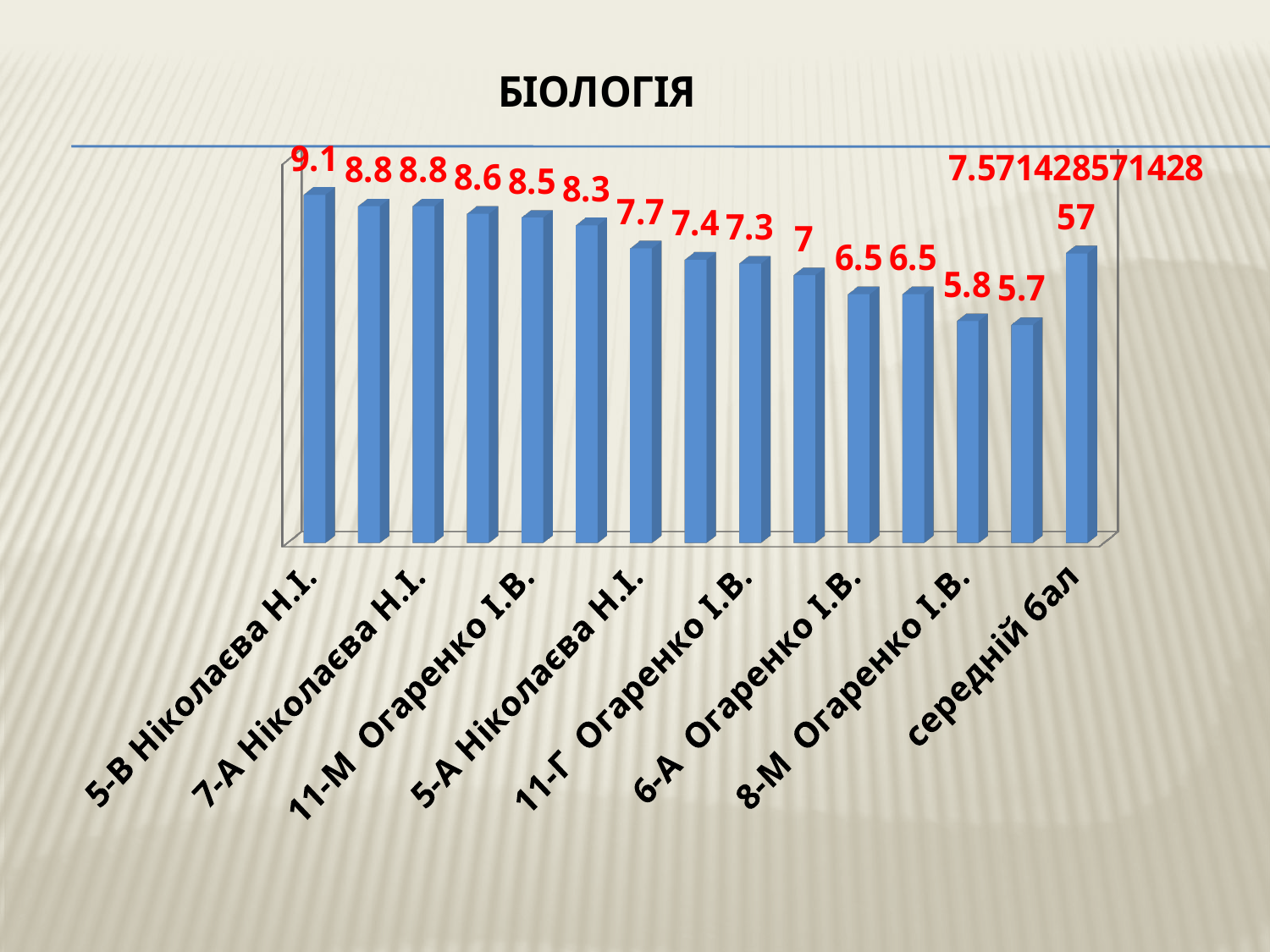
Do the class values rise or fall from left to right before the final 'середній бал' bar? fall What is the value for 11-М Огаренко І.В.? 8.5 What is the value for 6-А Огаренко І.В.? 6.5 How many bars does the chart contain? 15 Which labelled category has the highest value? 5-В Ніколаєва Н.І. What is the difference between the values for 5-В Ніколаєва Н.І. and 8-М Огаренко І.В.? 3.3 What is the value for 5-В Ніколаєва Н.І.? 9.1 What is the title of the chart? БІОЛОГІЯ Which is larger, the value for 11-М Огаренко І.В. or 11-Г Огаренко І.В.? 11-М Огаренко І.В. What kind of chart is shown on the slide? bar chart What is the lowest value shown on the chart? 5.7 What is the value for 8-М Огаренко І.В.? 5.8